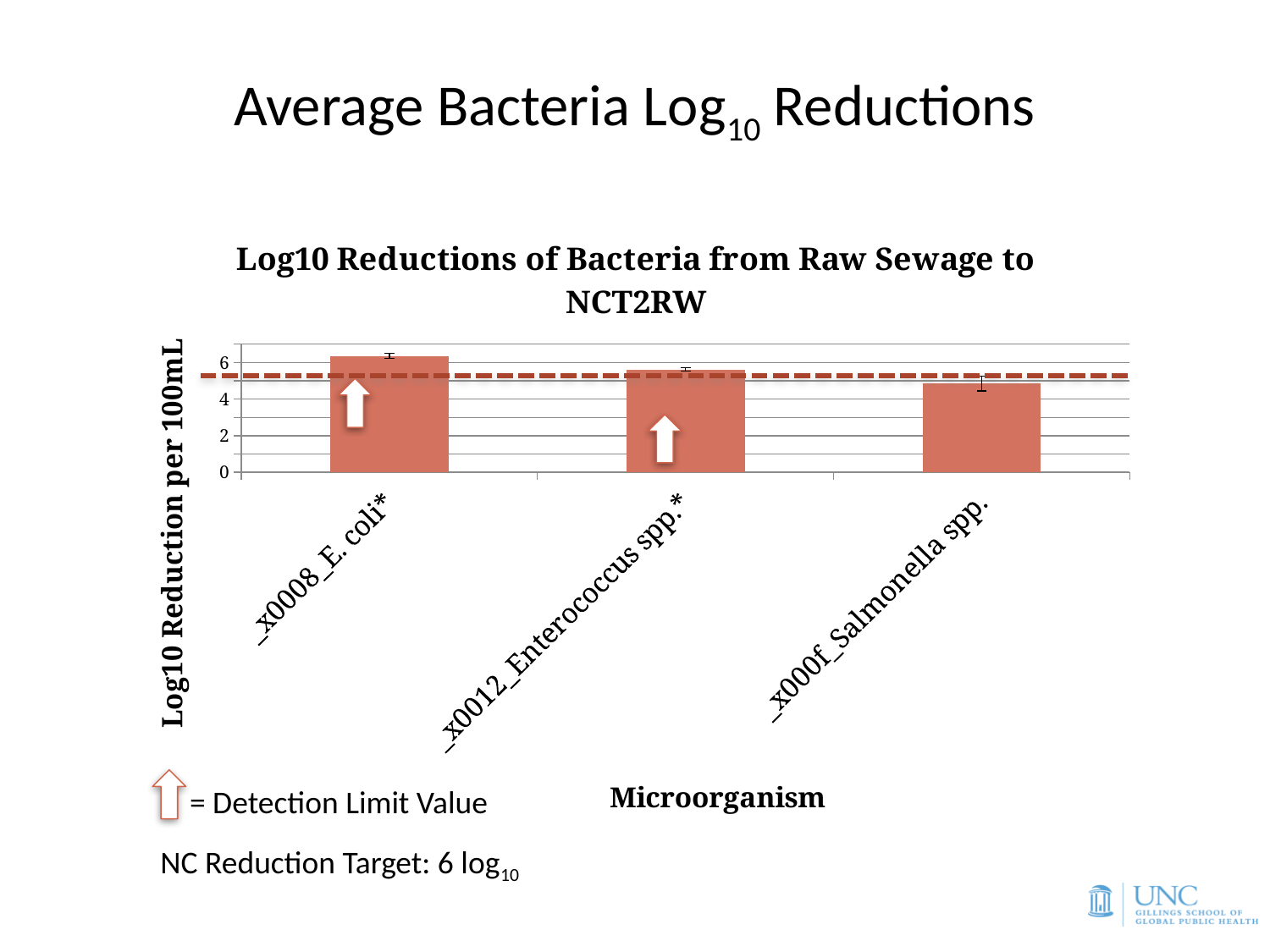
Which has a larger log10 reduction, _x0012_Enterococcus spp.* or _x000f_Salmonella spp.? _x0012_Enterococcus spp.* Is the value for _x000f_Salmonella spp. greater or less than 6? less Which microorganism has the highest log10 reduction in the chart? _x0008_E. coli* Is the value for _x0012_Enterococcus spp.* greater or less than 4? greater What is the label of the x axis of the chart? Microorganism Which has a larger log10 reduction, _x0008_E. coli* or _x000f_Salmonella spp.? _x0008_E. coli* How many microorganism categories are plotted in the chart? 3 What kind of chart is shown on the slide? bar chart Is the value for _x0012_Enterococcus spp.* greater or less than 6? less What is the title of the chart? Log10 Reductions of Bacteria from Raw Sewage to NCT2RW Which microorganism has the lowest log10 reduction in the chart? _x000f_Salmonella spp.